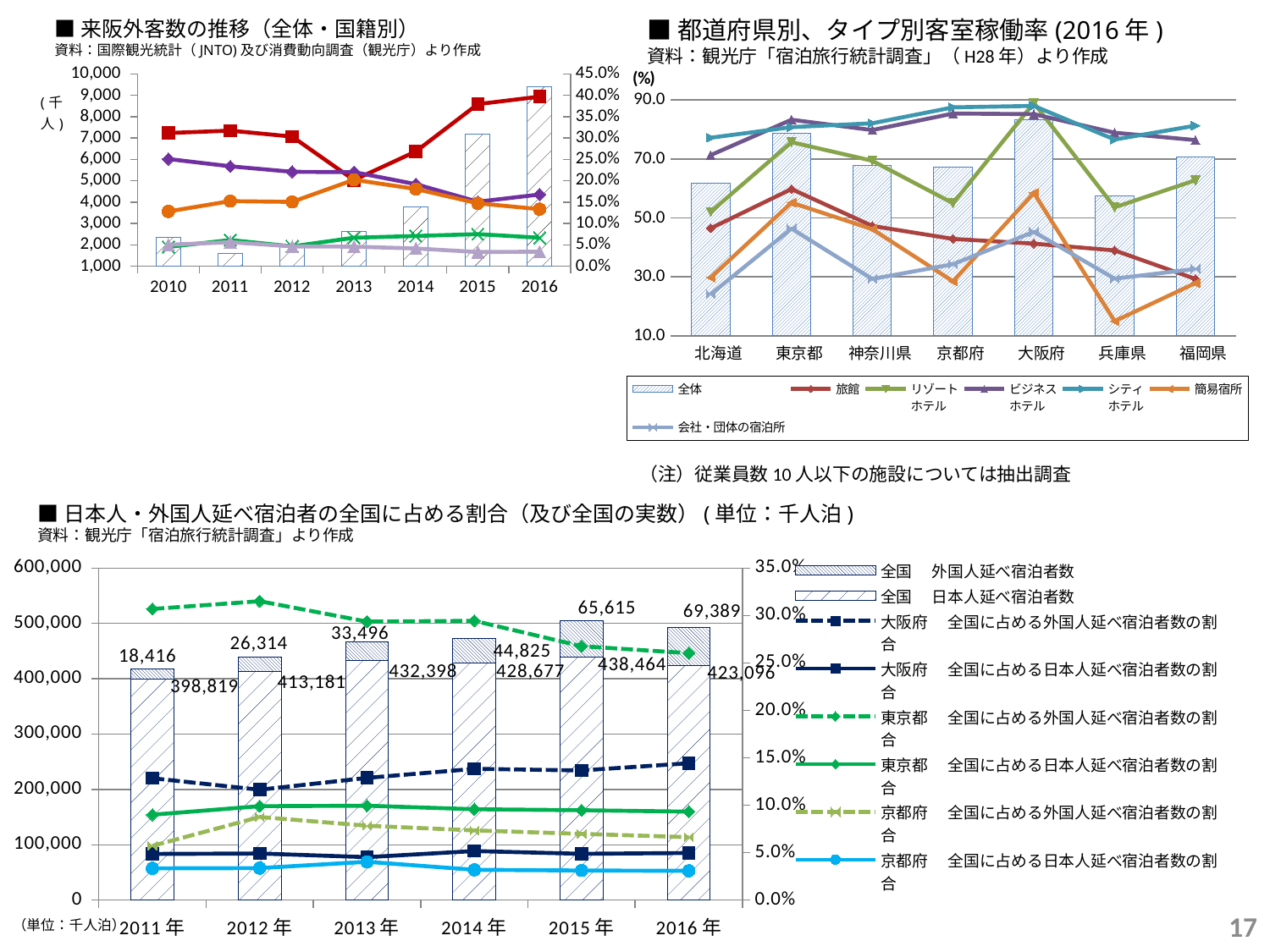
In the bottom chart (日本人・外国人延べ宿泊者の全国に占める割合), what is the value of 全国 外国人延べ宿泊者数 for 2016年? 69,389 In the bottom chart (日本人・外国人延べ宿泊者の全国に占める割合), what is the value of 全国 日本人延べ宿泊者数 for 2013年? 432,398 In the bottom chart (日本人・外国人延べ宿泊者の全国に占める割合), does the 全国 外国人延べ宿泊者数 rise or fall from 2011年 to 2016年? rises In the top-left chart (来阪外客数の推移), how many years are shown on the x axis? 7 In the bottom chart (日本人・外国人延べ宿泊者の全国に占める割合), what is the total of the stacked bar for 2011年? 417,235 In the top-right chart (都道府県別、タイプ別客室稼働率), how many prefectures are shown on the x axis? 7 In the top-right chart (都道府県別、タイプ別客室稼働率), which prefecture has the highest 全体 bar? 大阪府 In the bottom chart (日本人・外国人延べ宿泊者の全国に占める割合), which is larger, the 全国 日本人延べ宿泊者数 for 2013年 or for 2014年? 2013年 In the bottom chart (日本人・外国人延べ宿泊者の全国に占める割合), which year has the highest 全国 日本人延べ宿泊者数? 2015年 In the bottom chart (日本人・外国人延べ宿泊者の全国に占める割合), what is the difference between the 全国 外国人延べ宿泊者数 values for 2016年 and 2015年? 3,774 In the top-right chart (都道府県別、タイプ別客室稼働率), is the value of 簡易宿所 for 兵庫県 greater or less than 30.0? less In the bottom chart (日本人・外国人延べ宿泊者の全国に占める割合), how many entries does the legend list? 8